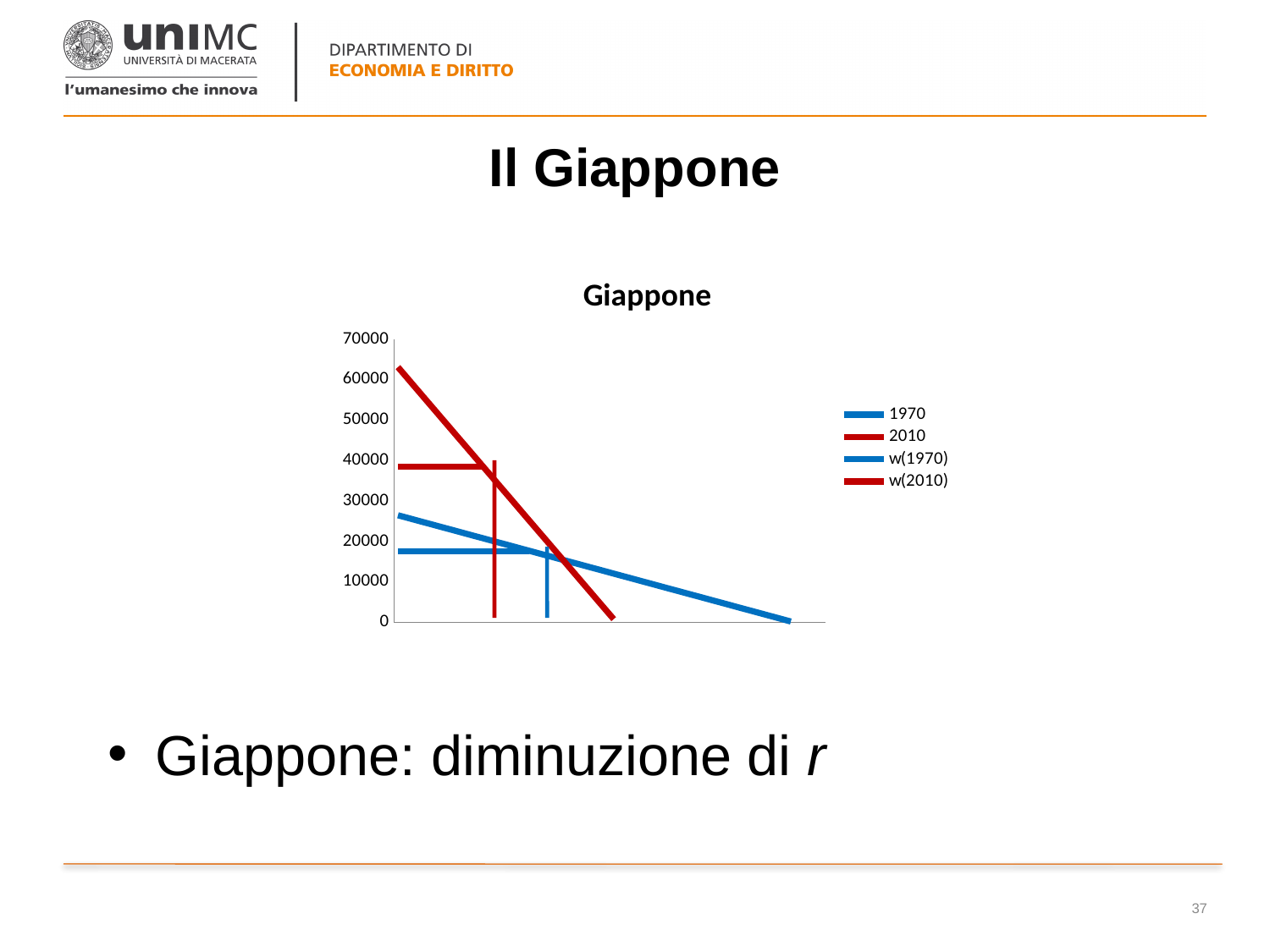
How many series does the legend of the Giappone chart list? 4 Is the starting value of the 2010 line at the left of the chart greater or less than 60000? greater Which series are listed in the legend of the chart? 1970, 2010, w(1970), w(2010) Is the starting value of the 1970 line at the left of the chart greater or less than 30000? less What kind of chart is shown on the slide? line chart Which series reaches the highest value on the chart, 1970 or 2010? 2010 Which horizontal line is higher on the chart, w(1970) or w(2010)? w(2010) Does the 2010 line rise or fall as it moves to the right along the x axis? fall Is the level of the horizontal w(1970) line greater or less than 20000? less What is the title of the chart? Giappone Does the 1970 line rise or fall as it moves to the right along the x axis? fall What is the highest value shown on the y axis of the chart? 70000